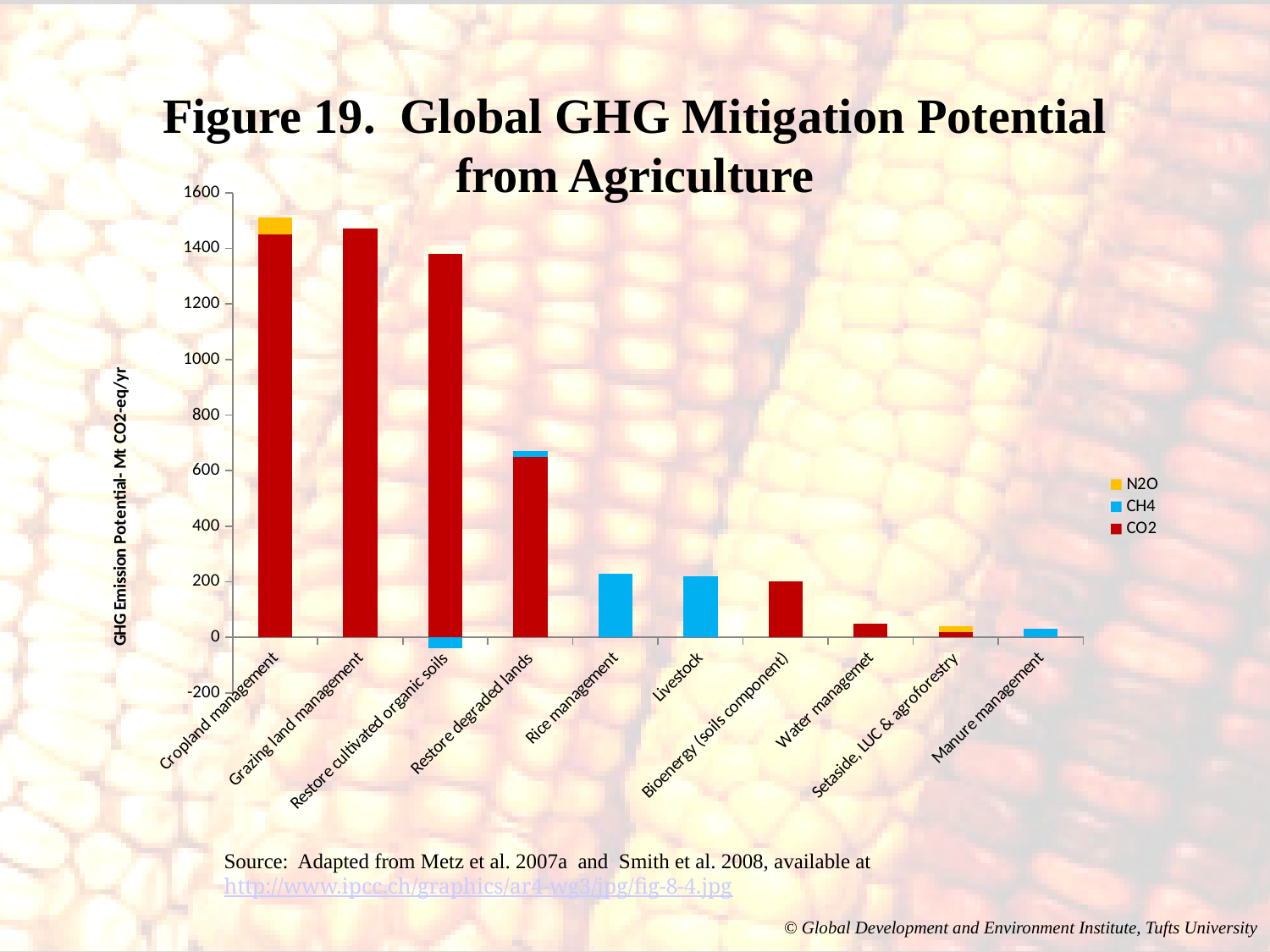
Is the value for Rice management greater or less than 400? less Do the bar heights generally rise or fall moving from left to right along the x axis? fall Is the value for Restore degraded lands greater or less than 600? greater Is the value for Water management greater or less than 200? less How many categories are shown on the x axis of the chart? 10 What kind of chart is shown on the slide? bar chart Which series are listed in the legend? N2O, CH4, CO2 What is the label on the vertical axis? GHG Emission Potential- Mt CO2-eq/yr Which is larger, the value for Cropland management or the value for Restore degraded lands? Cropland management How many series does the legend list? 3